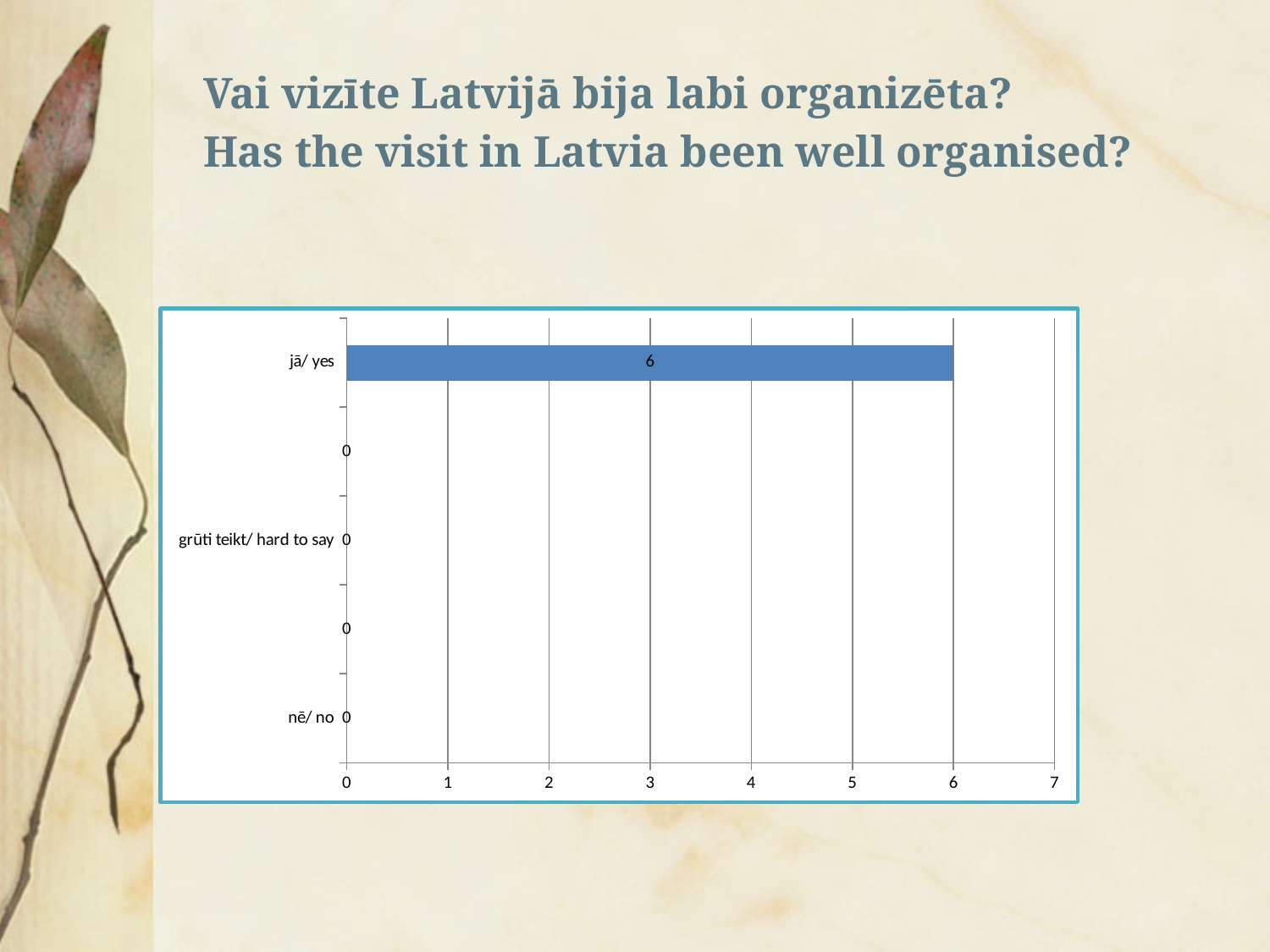
What is the difference between the values for "jā/ yes" and "nē/ no"? 6 What is the value for "jā/ yes"? 6 What is the English version of the question in the slide title? Has the visit in Latvia been well organised? Which category has the highest value? jā/ yes How many data labels are printed on the chart? 5 What kind of chart is shown on the slide? bar chart What is the highest value shown on the horizontal axis? 7 Which is larger, the value for "jā/ yes" or the value for "grūti teikt/ hard to say"? jā/ yes Is the value for "jā/ yes" greater or less than 5? greater What is the value for "nē/ no"? 0 What is the value for "grūti teikt/ hard to say"? 0